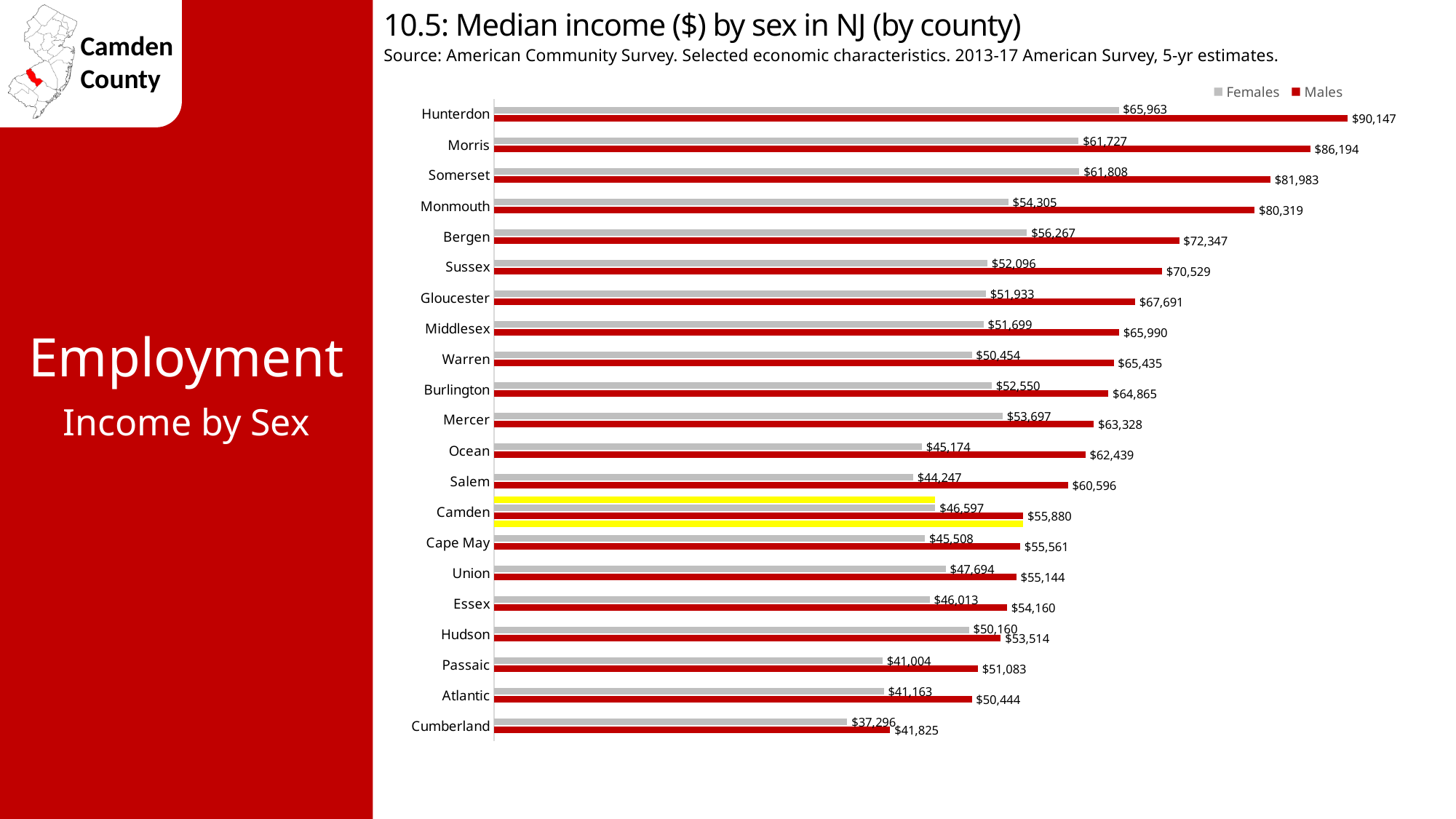
Which county has the highest median income for males? Hunterdon What is the difference between male and female median income in Camden county? $9,283 Which county's bars are highlighted in yellow? Camden Which county has the lowest median income for females? Cumberland What type of chart is shown on the slide? Bar chart What is the median income for males in Camden county? $55,880 How many series does the legend list? 2 What is the median income for females in Hunterdon county? $65,963 Which is larger, the female median income in Bergen or in Monmouth? Bergen How many counties are shown in the chart? 21 What is the difference between male and female median income in Hunterdon county? $24,184 What is the median income for females in Cumberland county? $37,296